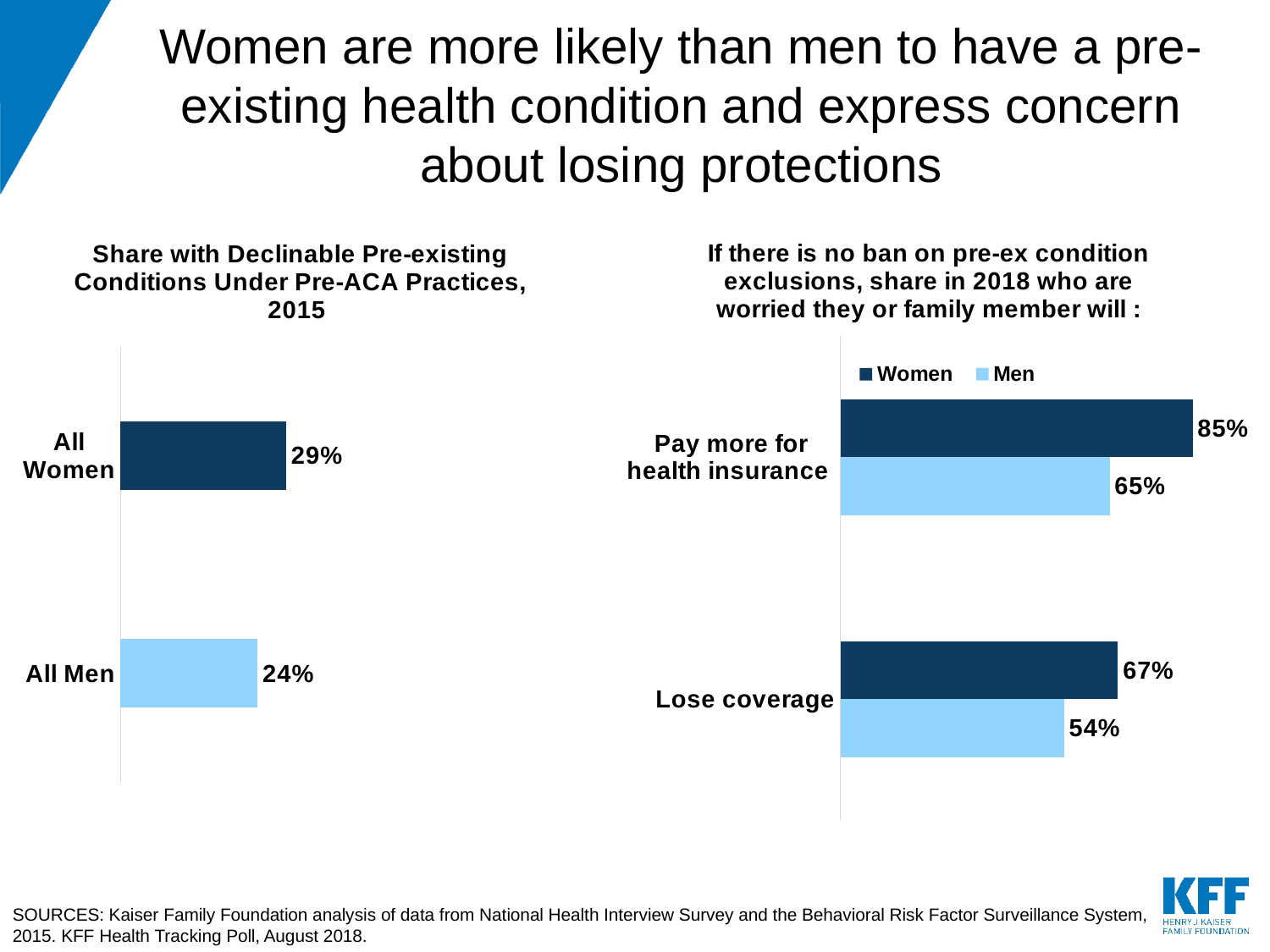
In the right chart (share worried if there is no ban on pre-ex condition exclusions), what is the difference between women and men for 'Pay more for health insurance'? 20 percentage points In the right chart (share worried if there is no ban on pre-ex condition exclusions), which colour represents Men in the legend? Light blue In the right chart (share worried if there is no ban on pre-ex condition exclusions), what share of men are worried they will lose coverage? 54% In the left chart (Share with Declinable Pre-existing Conditions Under Pre-ACA Practices, 2015), which category has the higher value? All Women In the left chart (Share with Declinable Pre-existing Conditions Under Pre-ACA Practices, 2015), what is the value for All Men? 24% In the left chart (Share with Declinable Pre-existing Conditions Under Pre-ACA Practices, 2015), what is the value for All Women? 29% In the left chart (Share with Declinable Pre-existing Conditions Under Pre-ACA Practices, 2015), how many categories are shown? 2 In the right chart (share worried if there is no ban on pre-ex condition exclusions), how many series does the legend list? 2 In the left chart (Share with Declinable Pre-existing Conditions Under Pre-ACA Practices, 2015), what is the difference between the values for All Women and All Men? 5 percentage points In the right chart (share worried if there is no ban on pre-ex condition exclusions), which is larger: the men's value for 'Pay more for health insurance' or the women's value for 'Lose coverage'? Women's value for Lose coverage (67%) In the right chart (share worried if there is no ban on pre-ex condition exclusions), what share of women are worried they will pay more for health insurance? 85% What type of chart is the right chart (share worried if there is no ban on pre-ex condition exclusions)? Bar chart